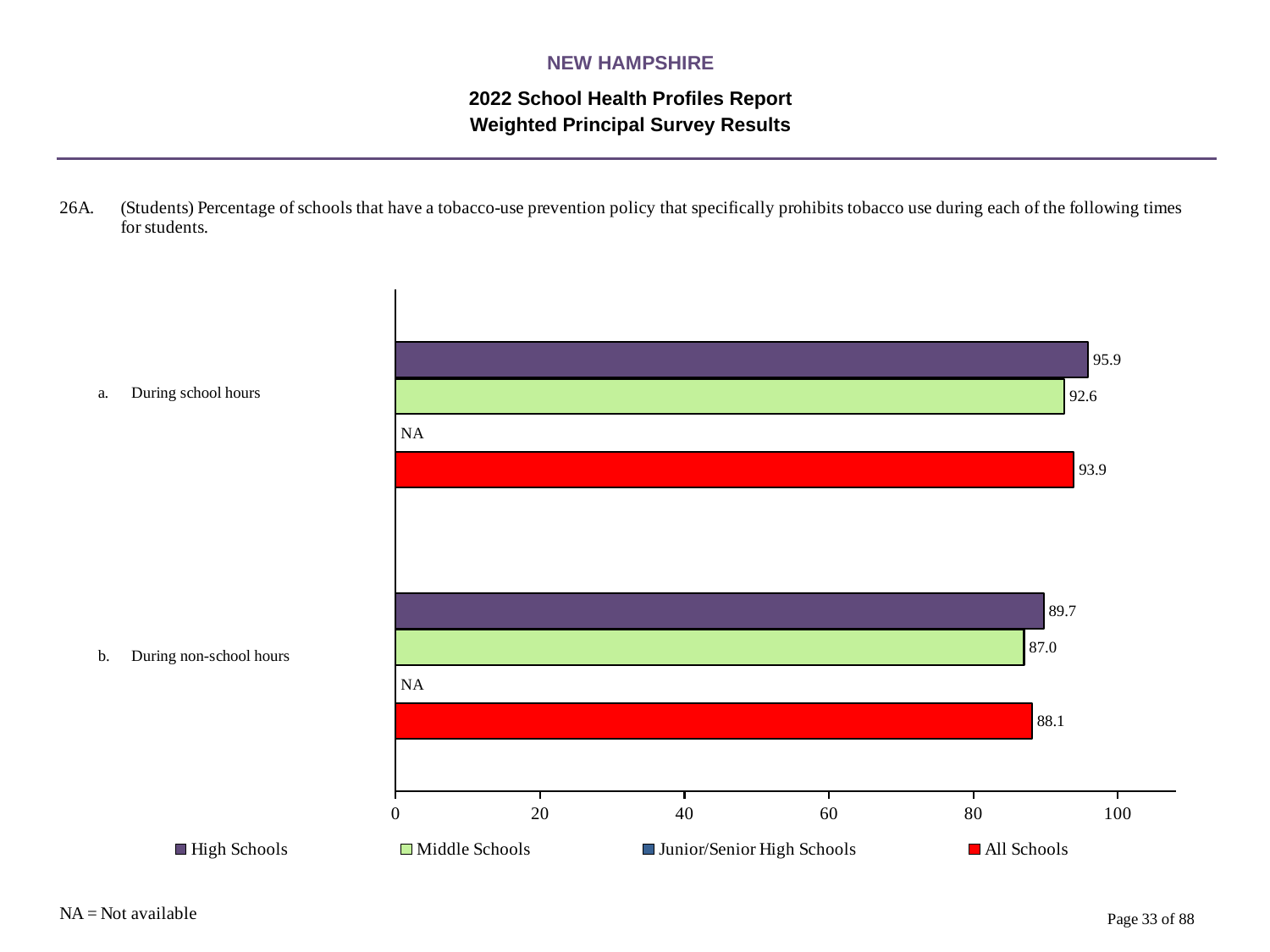
What is the value for Middle Schools during non-school hours? 87.0 What is the value for High Schools during school hours? 95.9 Which is larger: the All Schools value during school hours or during non-school hours? During school hours Which school type has the lowest printed value during school hours? Middle Schools Is the value for Middle Schools during non-school hours greater or less than 80? greater What is the value for All Schools during school hours? 93.9 What kind of chart is shown on the slide? Bar chart How many series does the legend list? 4 Which school type has the highest value during non-school hours? High Schools What colour represents All Schools in the legend? Red What is the value for Junior/Senior High Schools during school hours? NA What is the difference between the High Schools values for school hours and non-school hours? 6.2